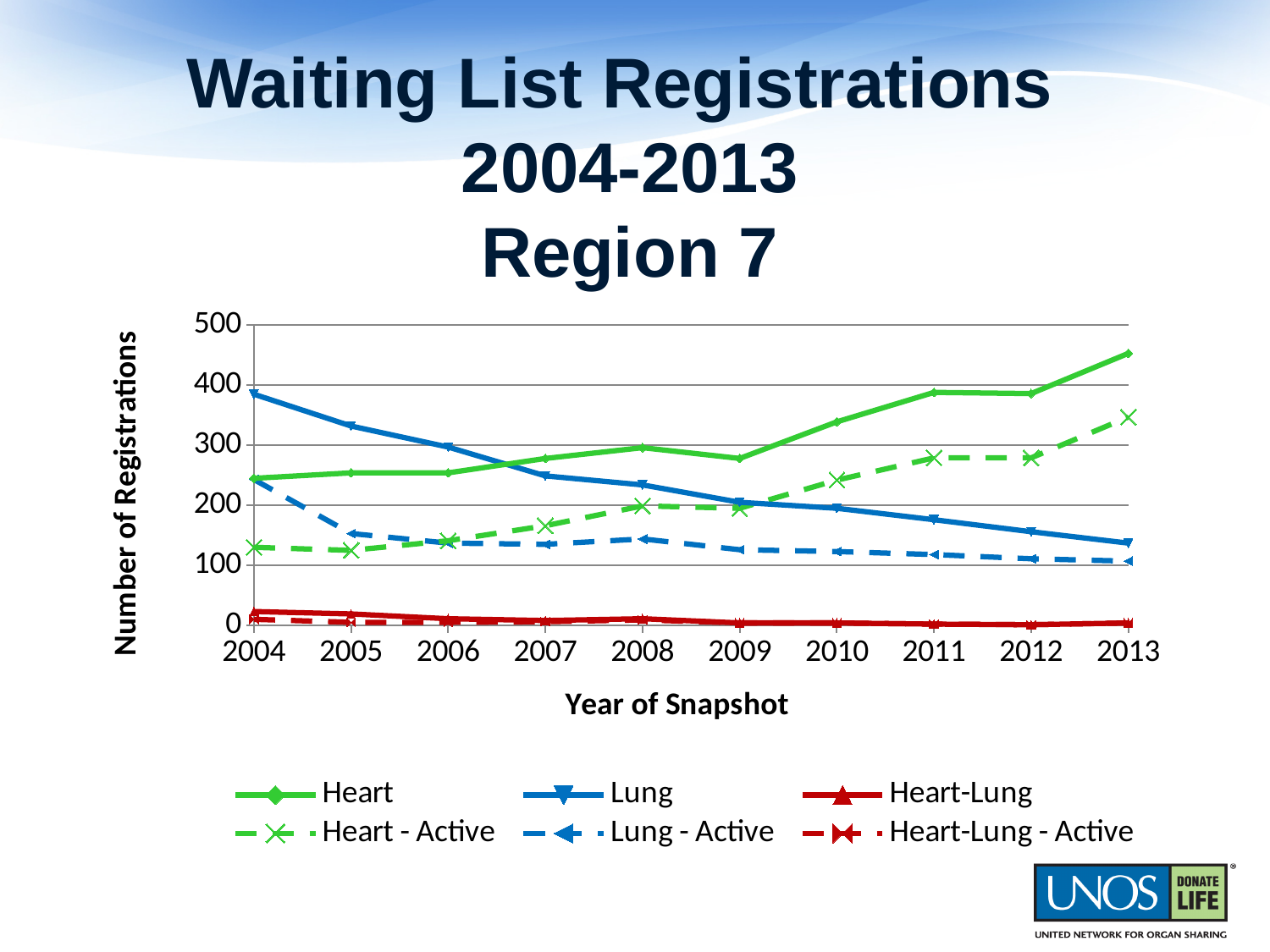
Is the value for Lung in 2004 greater or less than 300? greater Is the value for Heart in 2013 greater or less than 400? greater In which year is the Heart series at its highest? 2013 In 2013, which is larger, Heart or Lung? Heart Does the Heart series rise or fall from 2004 to 2013? rise What is the title of the x axis? Year of Snapshot In 2004, which is larger, Heart or Lung? Lung Does the Lung series rise or fall from 2004 to 2013? fall What kind of chart is shown on the slide? line chart In which year is the Lung series at its lowest? 2013 How many years are shown on the x axis? 10 How many series does the legend list? 6